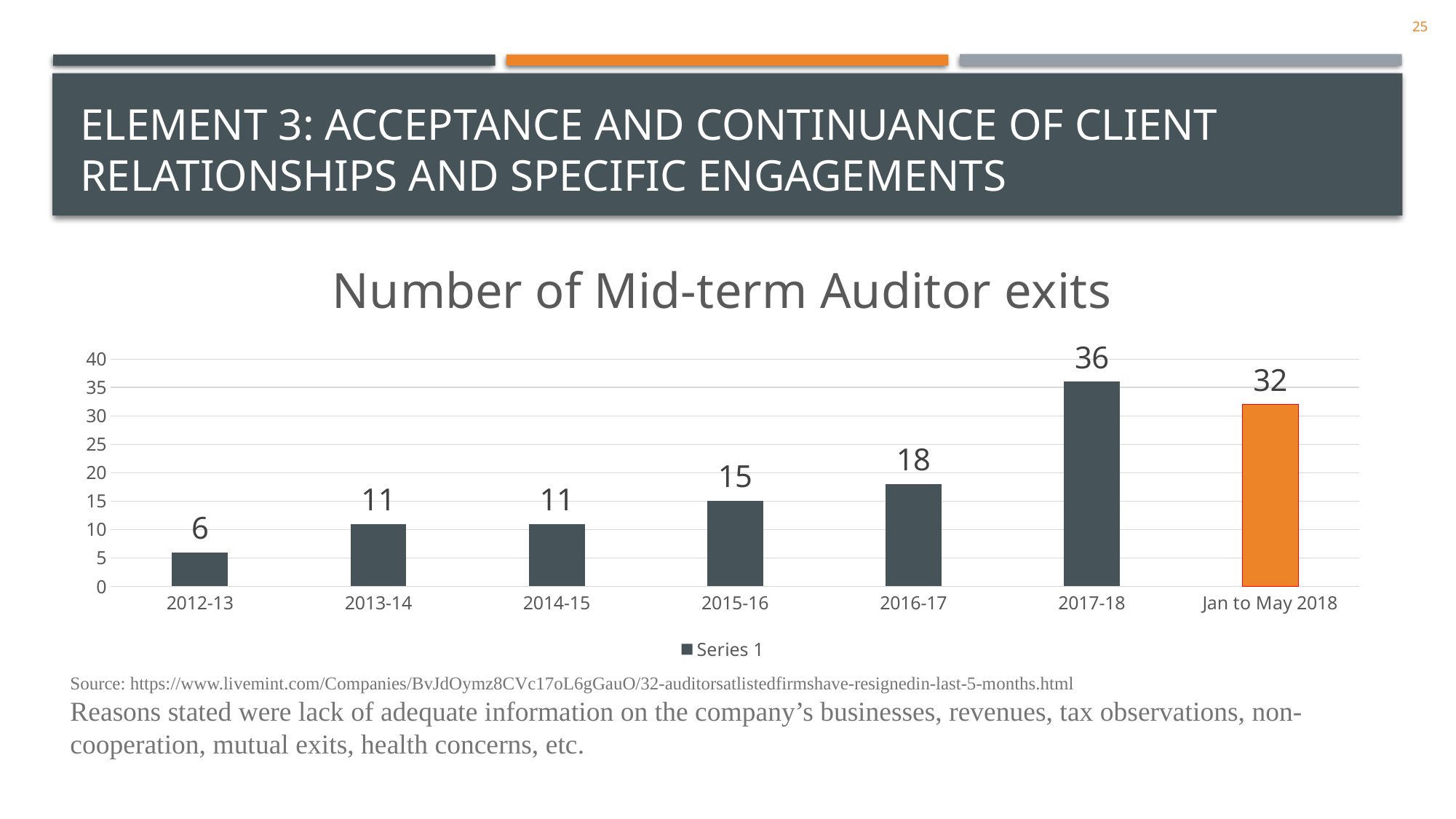
What is the value shown for Jan to May 2018? 32 How many series does the legend list? 1 Which category has the highest number of mid-term auditor exits? 2017-18 Is the value for 2016-17 greater or less than 20? less What is the number of mid-term auditor exits for 2017-18? 36 How many categories are shown on the x axis? 7 What kind of chart is shown on the slide? bar chart What is the title of the chart? Number of Mid-term Auditor exits What is the difference between the values for 2017-18 and 2016-17? 18 What is the number of mid-term auditor exits for 2012-13? 6 Which is larger, the value for 2015-16 or the value for 2014-15? 2015-16 Which category has the lowest number of mid-term auditor exits? 2012-13